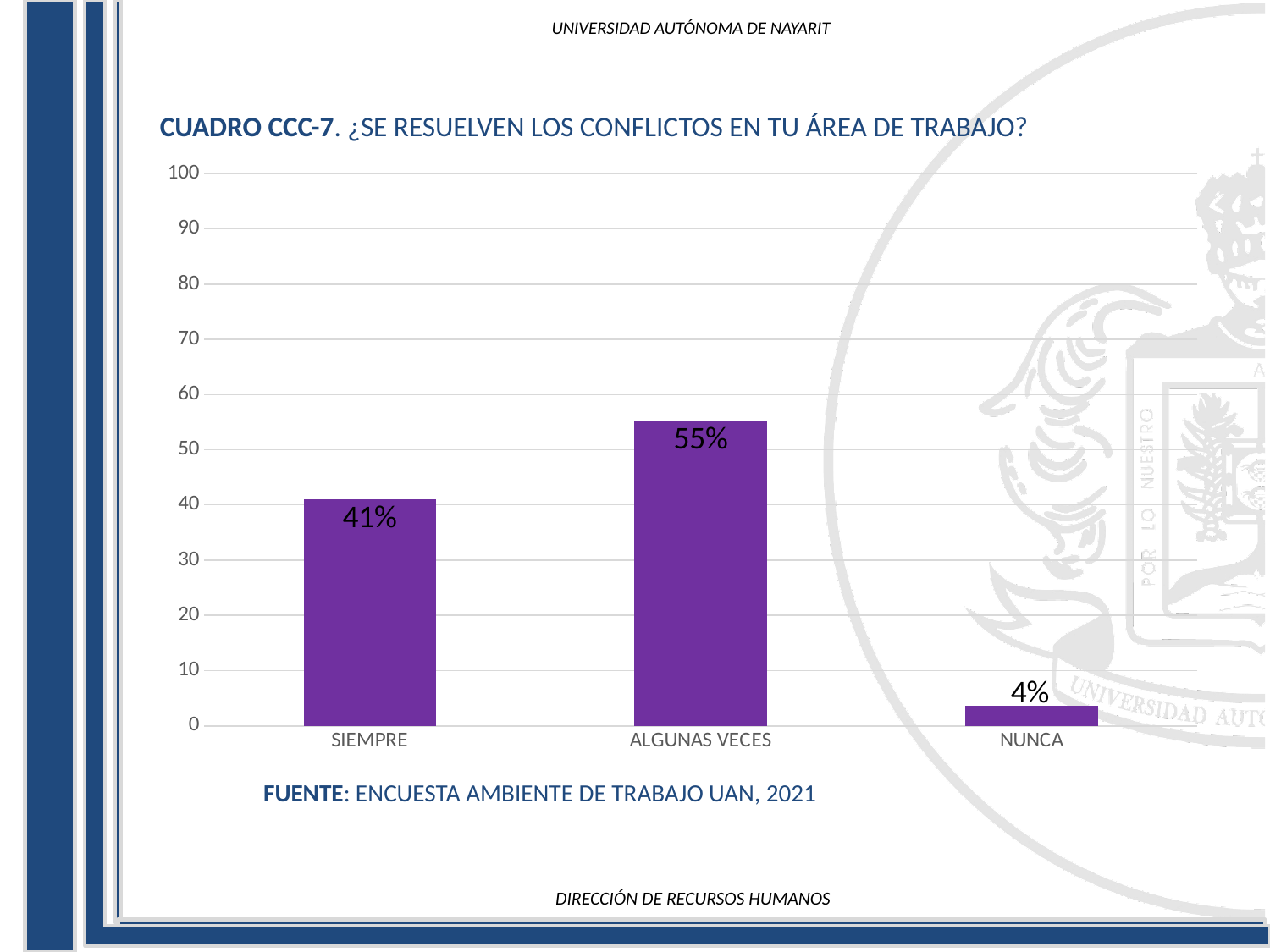
Which category has the highest value? ALGUNAS VECES What is the difference between the values for SIEMPRE and NUNCA? 37% Which category has the lowest value? NUNCA Which is larger, the value for SIEMPRE or the value for ALGUNAS VECES? ALGUNAS VECES What is the value for SIEMPRE? 41% What is the difference between the values for ALGUNAS VECES and SIEMPRE? 14% What kind of chart is shown on the slide? bar chart Is the value for ALGUNAS VECES greater or less than 50? greater How many categories are shown on the x axis? 3 What is the value for NUNCA? 4% What source is cited below the chart? ENCUESTA AMBIENTE DE TRABAJO UAN, 2021 What is the value for ALGUNAS VECES? 55%